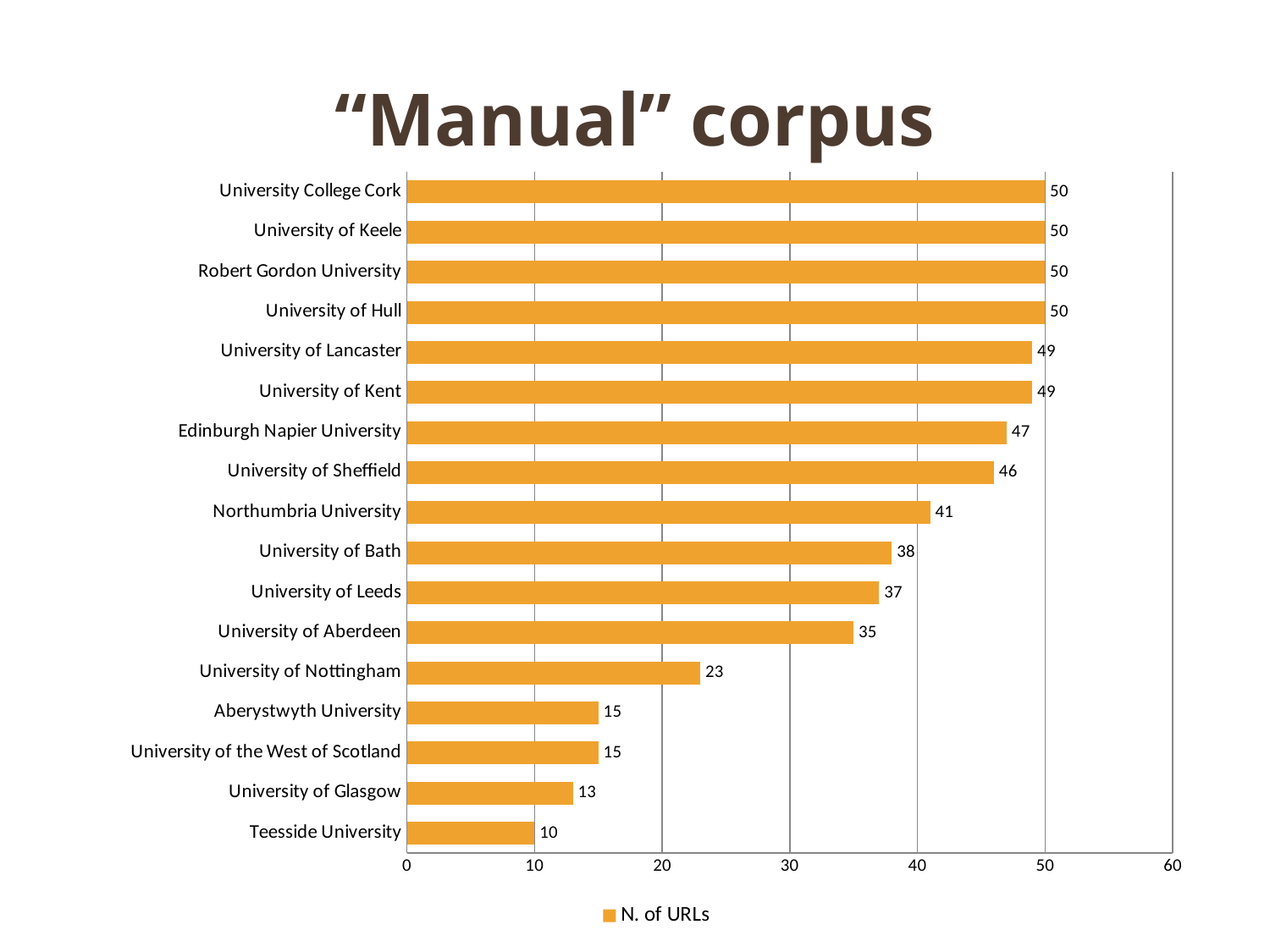
How many series does the legend list? 1 What is the difference in number of URLs between University of Bath and University of Aberdeen? 3 Which has more URLs, University of Leeds or University of Nottingham? University of Leeds What is the title of the chart? "Manual" corpus Which university has the lowest number of URLs? Teesside University What kind of chart is shown on the slide? bar chart How many universities are shown in the chart? 17 What is the number of URLs for Northumbria University? 41 What is the number of URLs for University of Nottingham? 23 What is the difference in number of URLs between University of Sheffield and Teesside University? 36 Is the value for Edinburgh Napier University greater or less than 40? greater What is the number of URLs for University of Glasgow? 13